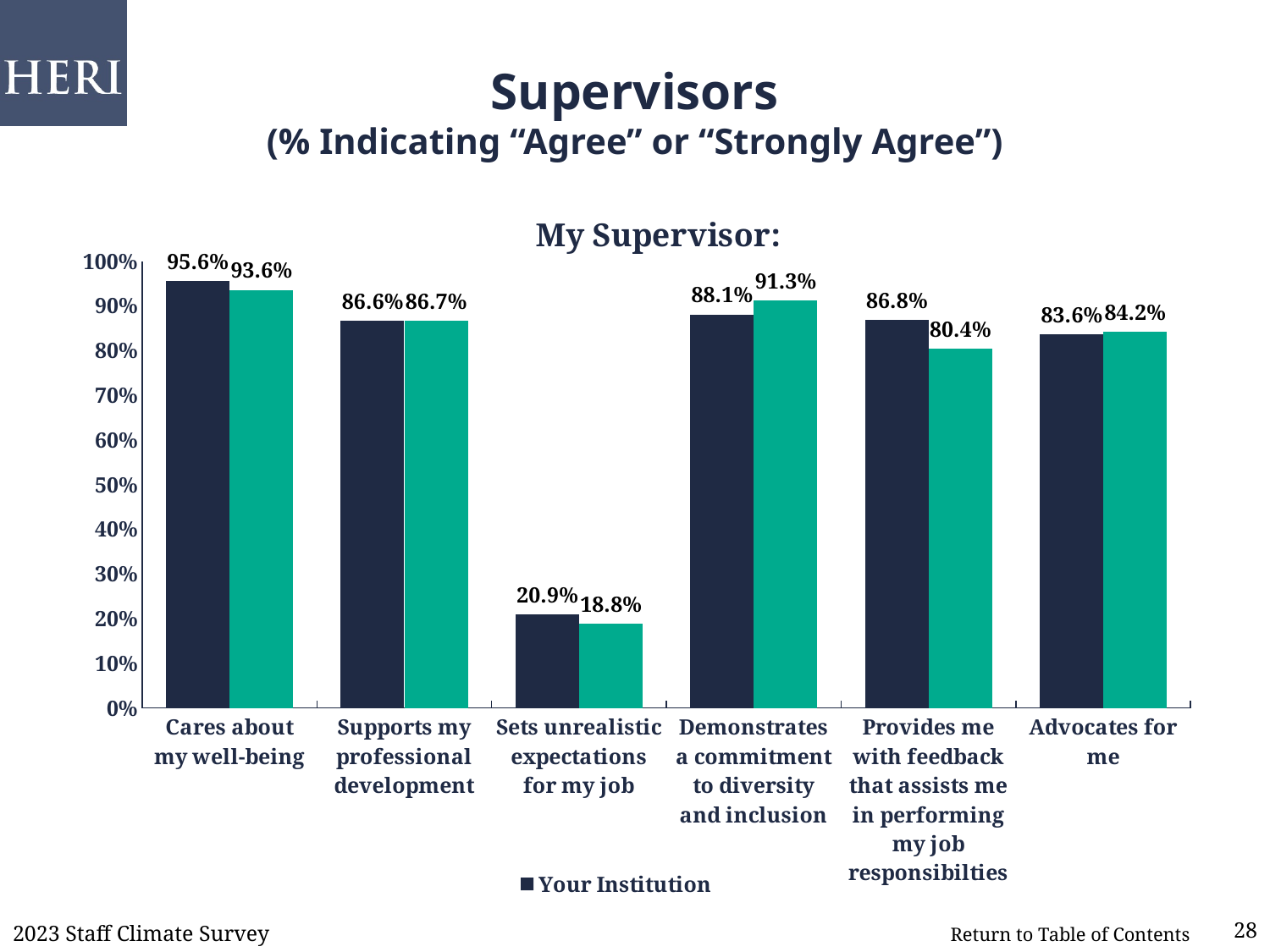
Which category has the highest value for "Your Institution"? Cares about my well-being What is the difference between the "Your Institution" value and the green bar value for "Provides me with feedback that assists me in performing my job responsibilties"? 6.4% Which category has the lowest value for "Your Institution"? Sets unrealistic expectations for my job For "Demonstrates a commitment to diversity and inclusion", which is larger: the "Your Institution" bar or the green bar? The green bar What kind of chart is shown on the slide? Bar chart What is the value of the green bar for "Demonstrates a commitment to diversity and inclusion"? 91.3% How many categories are shown on the x axis? 6 What is the value of the green bar for "Provides me with feedback that assists me in performing my job responsibilties"? 80.4% What is the value for "Your Institution" for "Cares about my well-being"? 95.6% What is the value for "Your Institution" for "Sets unrealistic expectations for my job"? 20.9% Is the "Your Institution" value for "Advocates for me" greater or less than 80%? greater What is the title shown above the chart? My Supervisor: